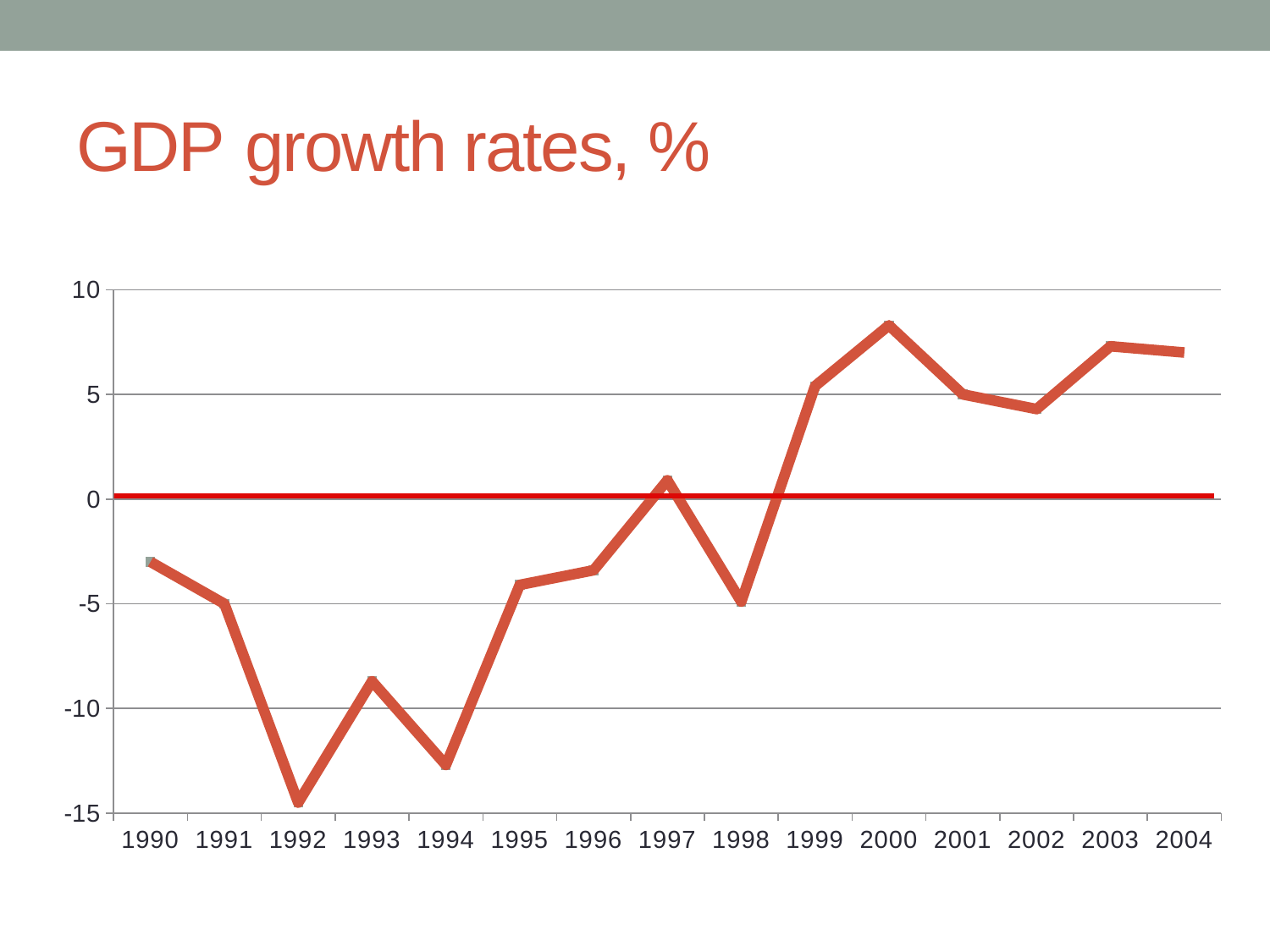
Which year has the larger GDP growth rate, 2000 or 2003? 2000 How many years are plotted along the x axis? 15 What kind of chart is shown on the slide? line chart Is the value for 1992 greater or less than -10? less Is the value for 1993 greater or less than -10? greater Overall, do the GDP growth rates rise or fall from 1990 to 2004? rise In which year is the GDP growth rate highest? 2000 Which year has the larger GDP growth rate, 1992 or 1994? 1994 In which year is the GDP growth rate lowest? 1992 Is the value for 1998 greater or less than 0? less What is the title of the chart? GDP growth rates, %